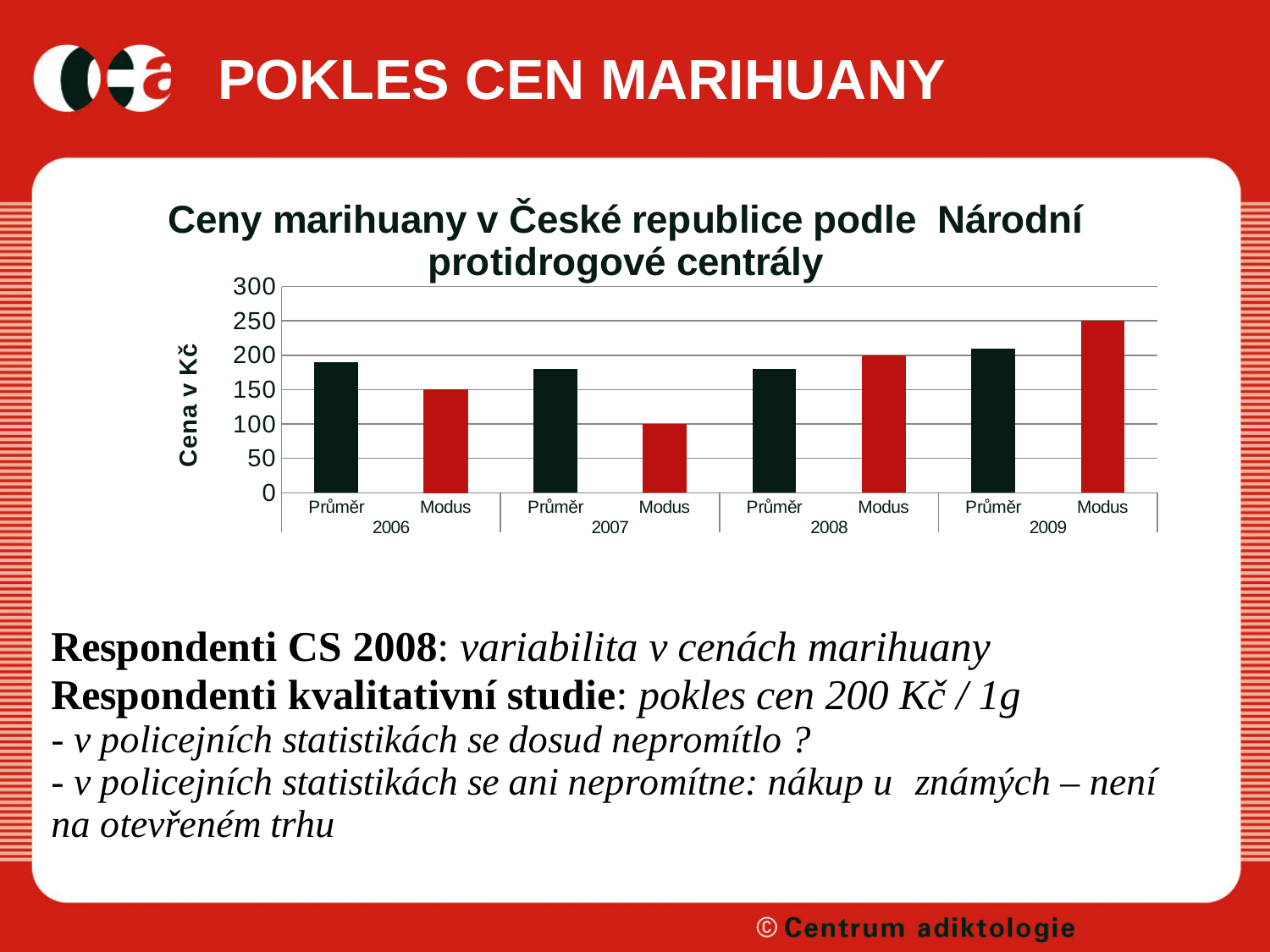
What kind of chart is shown on the slide? bar chart What is the difference between the Modus value for 2009 and the Modus value for 2007? 150 Is the Průměr value for 2006 greater or less than 150? greater Which bar has the lowest value in the chart? Modus 2007 What is the Modus value for 2009? 250 Is the Průměr value for 2009 greater or less than 250? less What is the Modus value for 2008? 200 What is the label of the vertical axis? Cena v Kč How many bars are plotted in the chart? 8 What is the Modus value for 2007? 100 Which bar has the highest value in the chart? Modus 2009 What is the Modus value for 2006? 150